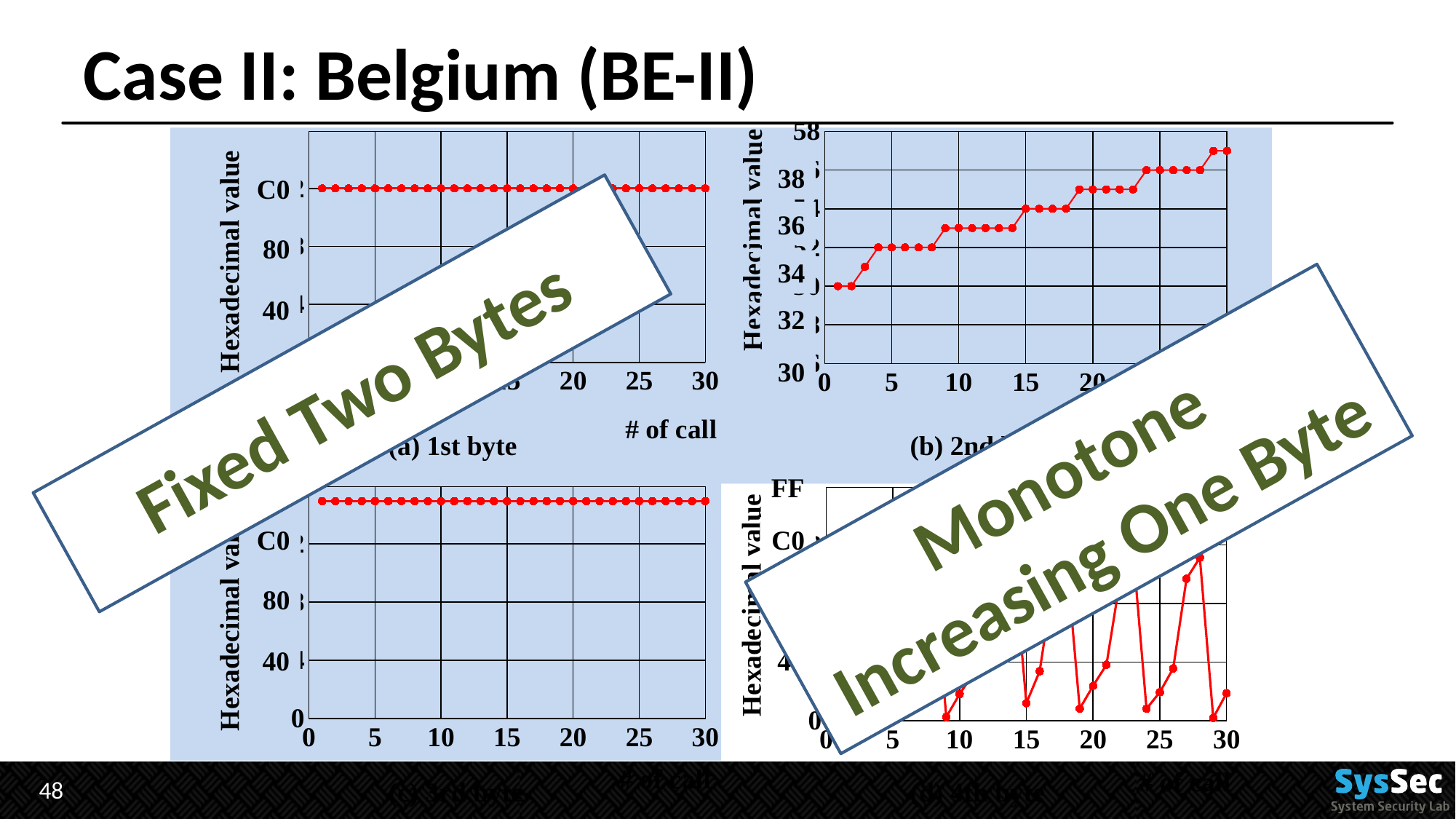
In the bottom-right chart, do the values increase steadily, or do they repeatedly rise and drop as the number of calls increases? repeatedly rise and drop What kind of chart is the top-left chart labelled (a) 1st byte? line chart In the top-right chart (b) 2nd byte, which is larger: the value at call 1 or the value at call 30? call 30 What is the y-axis label of the top-right chart (b) 2nd byte? Hexadecimal value What is the x-axis label of the top-left chart (a) 1st byte? # of call In the top-right chart (b) 2nd byte, do the values rise or fall as the number of calls increases? rise In the top-left chart (a) 1st byte, do the values rise, fall or stay constant as the number of calls increases? stay constant In the top-left chart (a) 1st byte, what hexadecimal value do all the plotted points take? C0 In the top-right chart (b) 2nd byte, is the value at call 30 greater or less than 36? greater In the top-right chart (b) 2nd byte, is the value at call 1 greater or less than 36? less In the bottom-left chart, is the plotted value greater or less than C0? greater